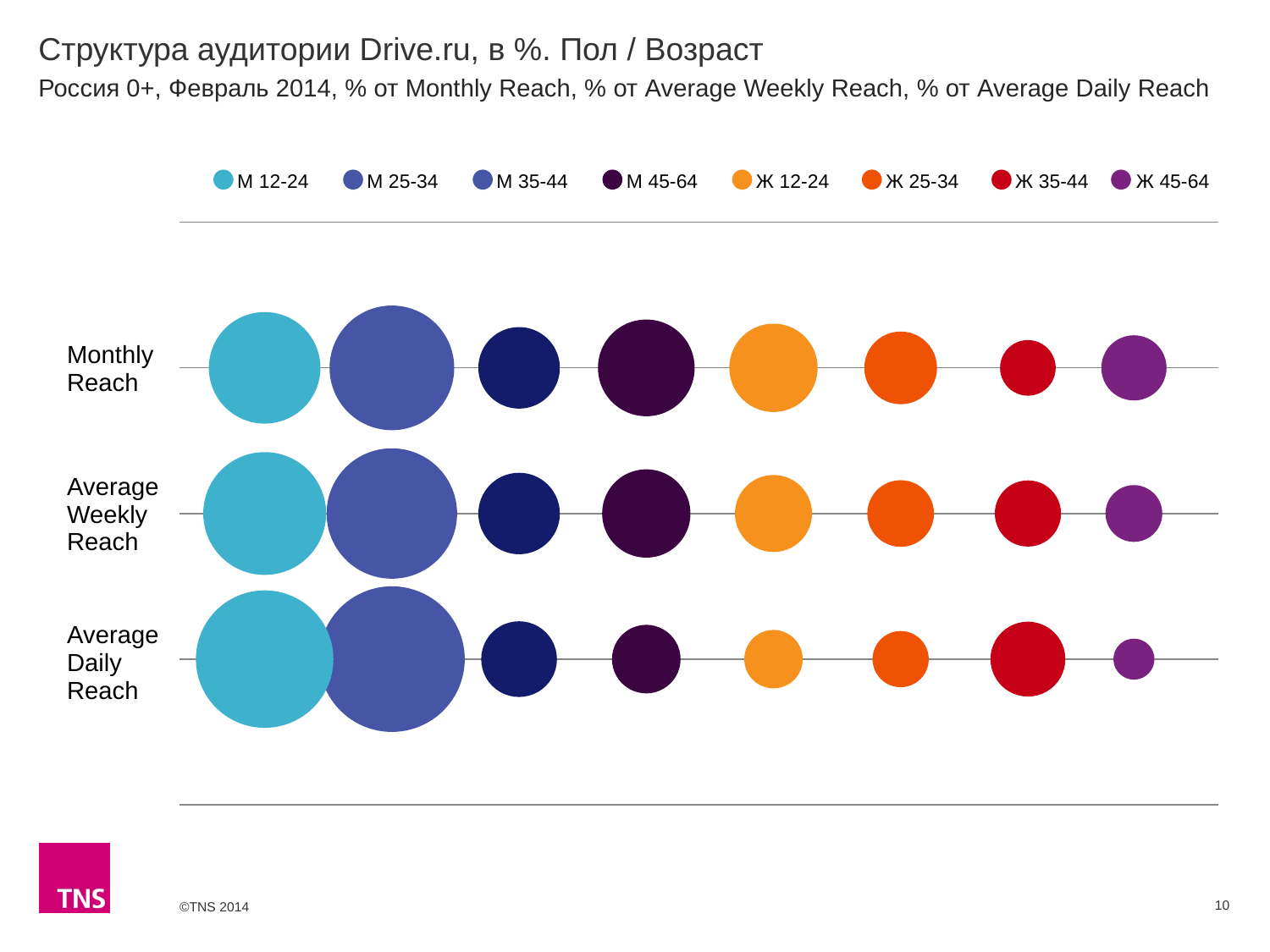
In the Average Daily Reach row, which bubble is larger: Ж 35-44 or Ж 12-24? Ж 35-44 How many series does the legend list? 8 Does the bubble for Ж 45-64 get larger or smaller going from Monthly Reach to Average Daily Reach? Smaller What kind of chart is shown on the slide? Bubble chart How many reach categories (rows) are plotted on the chart? 3 Which series has the smallest bubble in the Average Daily Reach row? Ж 45-64 Does the bubble for М 12-24 get larger or smaller going from Monthly Reach to Average Daily Reach? Larger In the Monthly Reach row, which bubble is larger: М 25-34 or Ж 45-64? М 25-34 What is the title of the slide? Структура аудитории Drive.ru, в %. Пол / Возраст Which series has the largest bubble in the Monthly Reach row? М 25-34 Which series has the smallest bubble in the Average Weekly Reach row? Ж 45-64 Which series is listed first in the legend? М 12-24